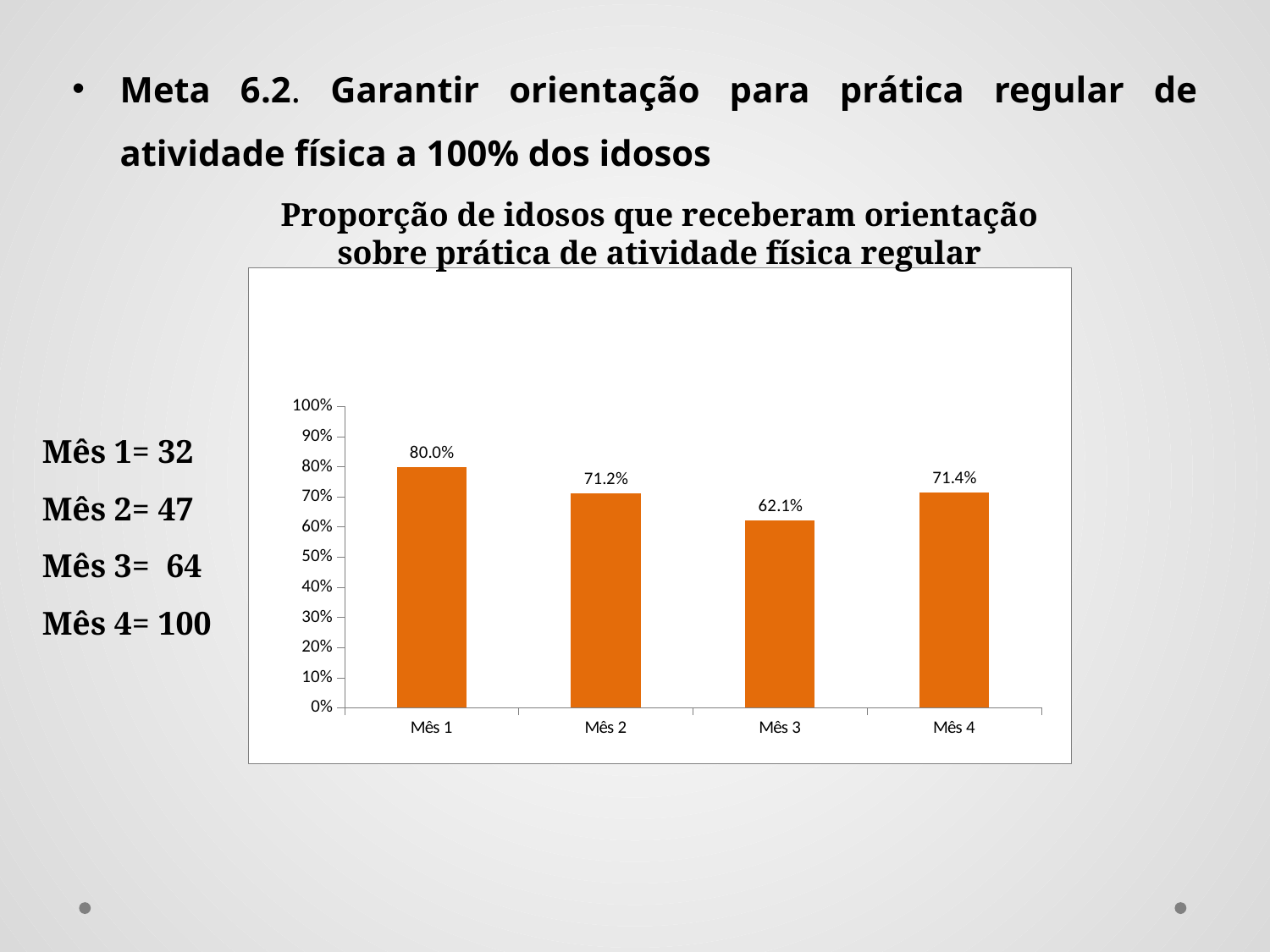
Is the value for Mês 3 greater or less than 70%? less What is the value for Mês 1? 80.0% Do the values rise or fall from Mês 1 to Mês 3? fall What is the value for Mês 4? 71.4% What is the value for Mês 3? 62.1% What kind of chart is shown? bar chart How many months are shown on the x axis? 4 What is the difference between the values for Mês 1 and Mês 3? 17.9 percentage points Which is larger, the value for Mês 1 or the value for Mês 2? Mês 1 What is the value for Mês 2? 71.2% Which month has the lowest value? Mês 3 Which month has the highest value? Mês 1